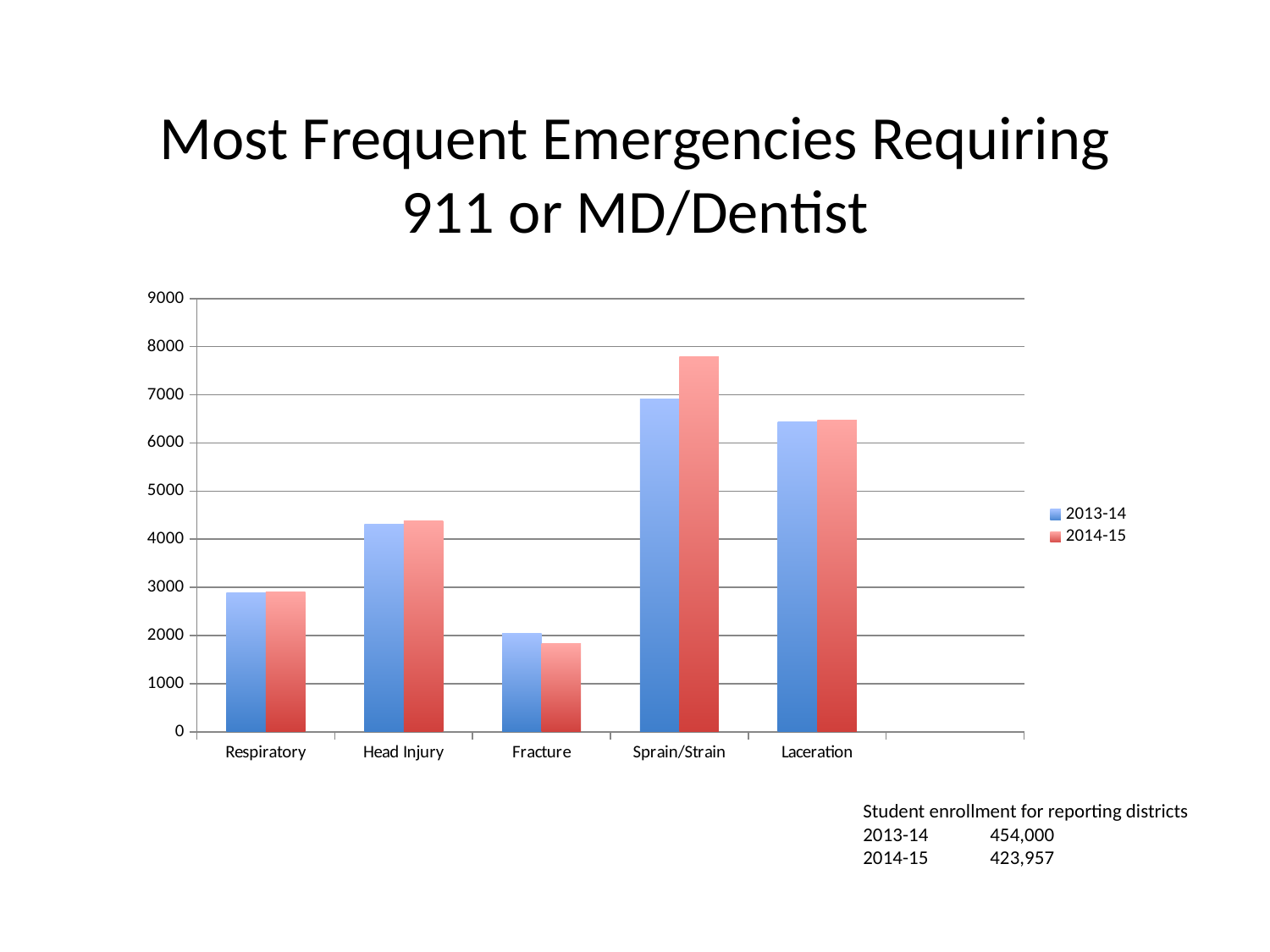
Is the value for Fracture in 2014-15 greater or less than 2000? less How many emergency categories are shown on the x axis? 5 What is the title of the chart? Most Frequent Emergencies Requiring 911 or MD/Dentist For Fracture, which year has the larger value, 2013-14 or 2014-15? 2013-14 Which category has the lowest value for 2014-15? Fracture Which category has the lowest value for 2013-14? Fracture Is the value for Laceration in 2013-14 greater or less than 6000? greater What kind of chart is shown on the slide? bar chart For Sprain/Strain, which year has the larger value, 2013-14 or 2014-15? 2014-15 Which category has the highest value for 2014-15? Sprain/Strain How many series does the legend list? 2 Is the value for Sprain/Strain in 2014-15 greater or less than 7000? greater